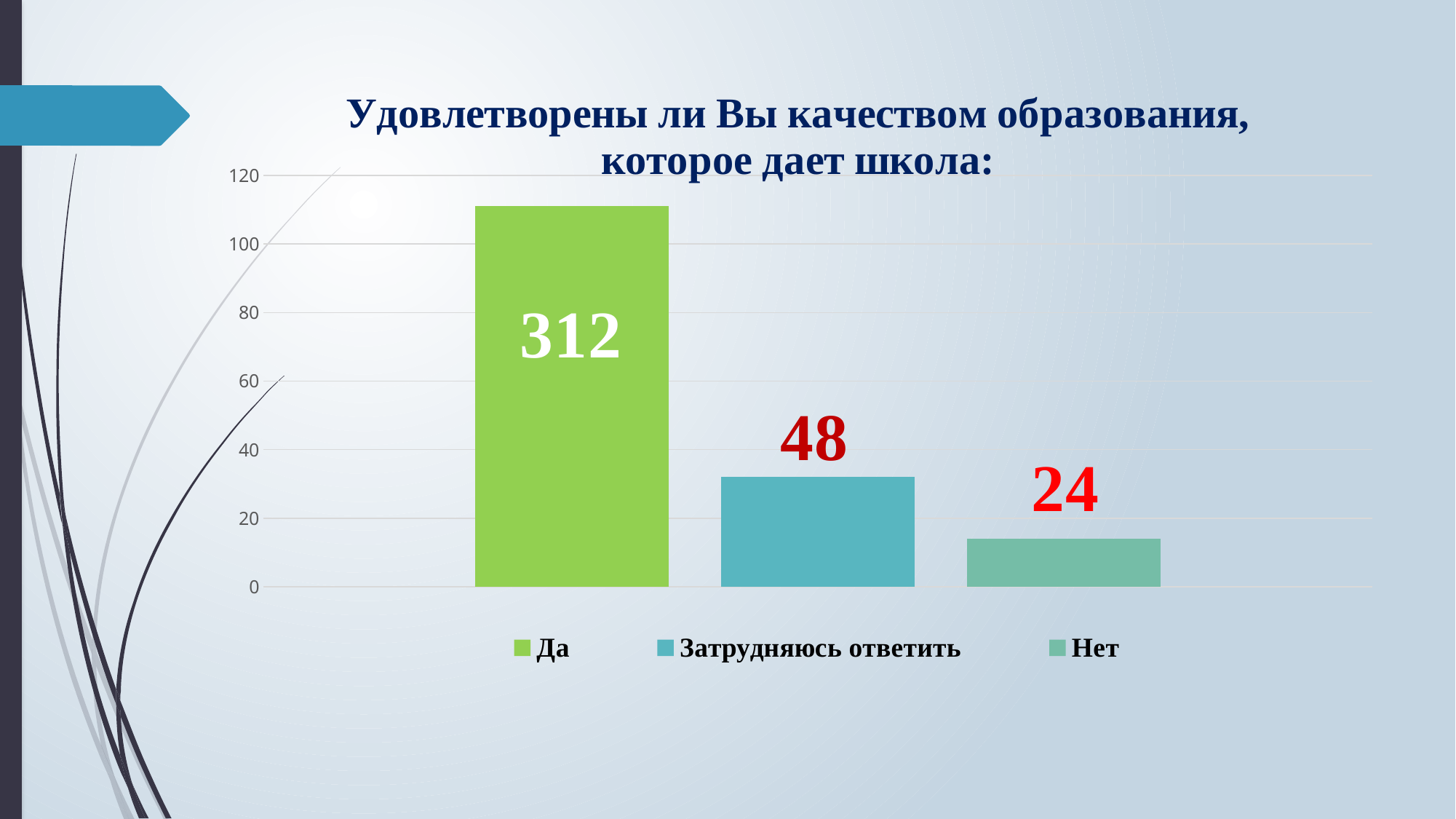
What is the difference between the values for "Да" and "Затрудняюсь ответить"? 264 Which is larger, the value for "Затрудняюсь ответить" or the value for "Нет"? Затрудняюсь ответить What value is shown for "Затрудняюсь ответить"? 48 How many categories are shown in the chart? 3 Which category has the lowest value? Нет What is the title of the chart? Удовлетворены ли Вы качеством образования, которое дает школа: What is the difference between the values for "Затрудняюсь ответить" and "Нет"? 24 What kind of chart is shown on the slide? Bar chart How many entries does the legend list? 3 Which category has the highest value? Да What value is shown for "Да"? 312 What value is shown for "Нет"? 24